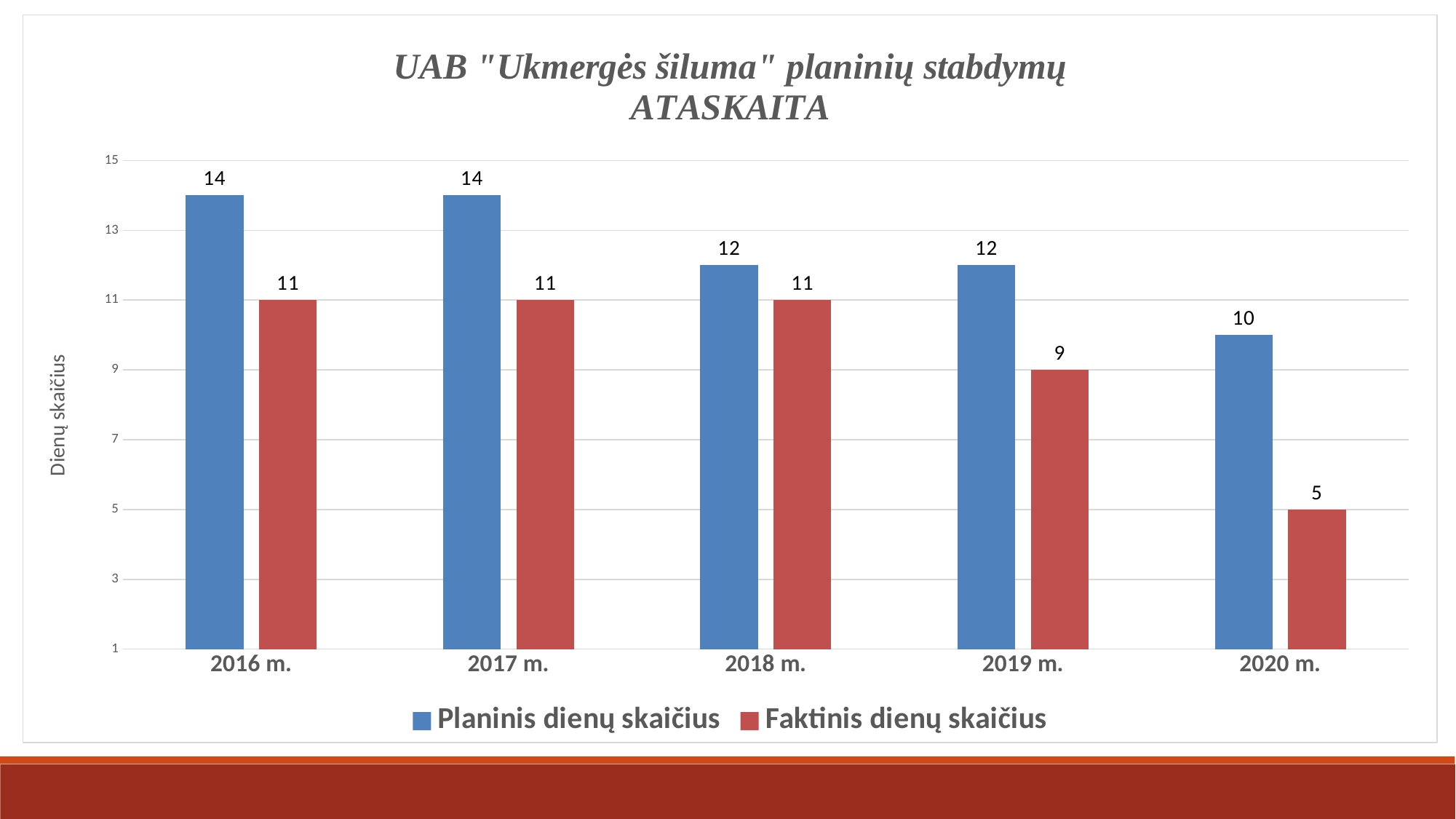
Which year has the lowest Planinis dienų skaičius? 2020 m. What is the difference between Planinis dienų skaičius and Faktinis dienų skaičius in 2020 m.? 5 What is the difference between Planinis dienų skaičius and Faktinis dienų skaičius in 2016 m.? 3 What is the value of Faktinis dienų skaičius for 2019 m.? 9 How many series does the legend list? 2 Which is larger in 2019 m., Planinis dienų skaičius or Faktinis dienų skaičius? Planinis dienų skaičius Which year has the lowest Faktinis dienų skaičius? 2020 m. What kind of chart is shown on the slide? Bar chart What is the value of Faktinis dienų skaičius for 2020 m.? 5 What is the value of Planinis dienų skaičius for 2018 m.? 12 How many years are shown on the x axis? 5 Does Faktinis dienų skaičius rise or fall from 2016 m. to 2020 m.? Fall